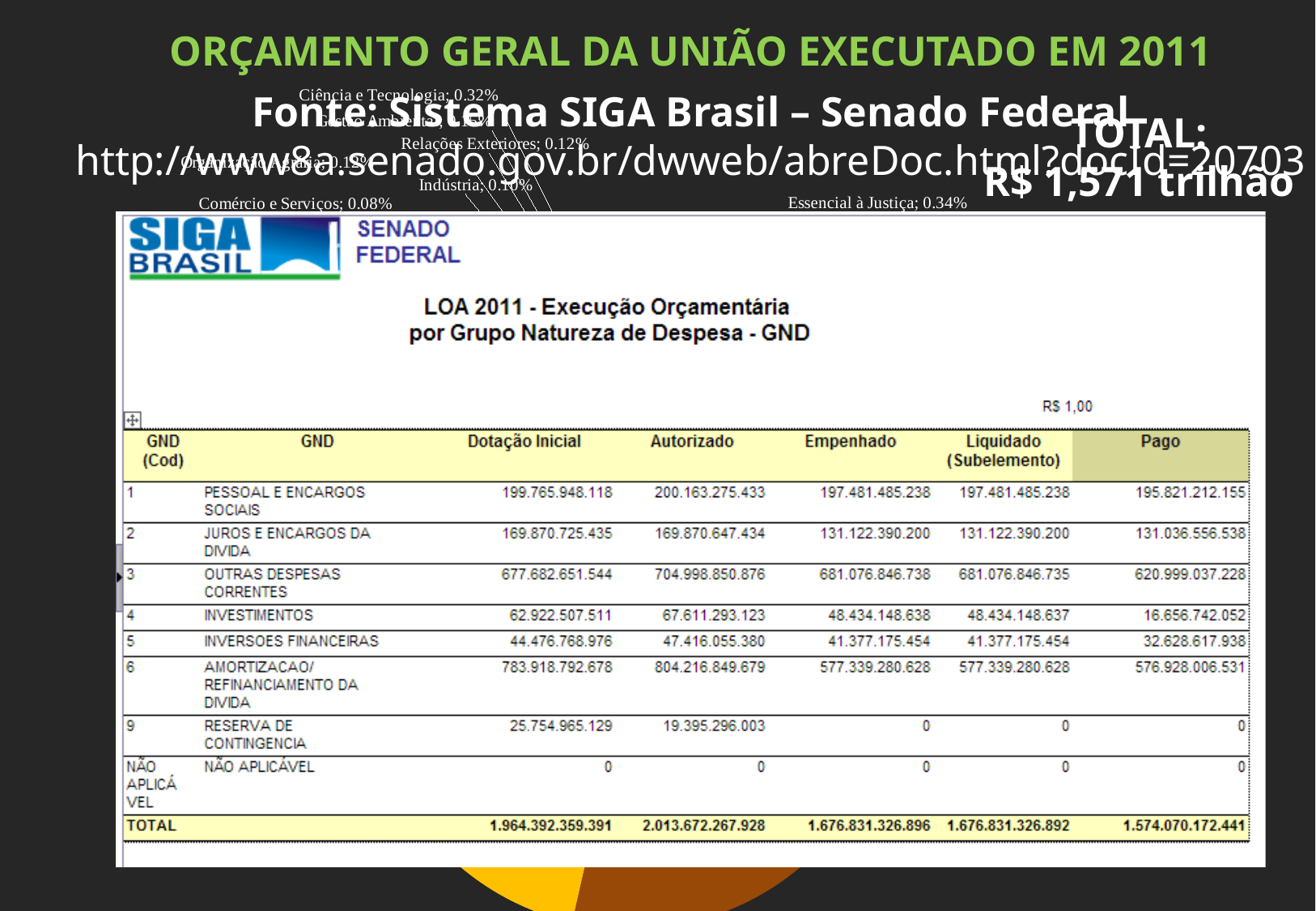
Among the labelled slices Comércio e Serviços, Indústria and Relações Exteriores, which has the smallest share? Comércio e Serviços What kind of chart is partially visible behind the table on the slide? pie chart What share does the Relações Exteriores slice have in the pie chart? 0.12% What is the title shown at the top of the slide above the chart? ORÇAMENTO GERAL DA UNIÃO EXECUTADO EM 2011 What share does the Ciência e Tecnologia slice have in the pie chart? 0.32% What share does the Indústria slice have in the pie chart? 0.10% In the pie chart, what is the difference between the shares of Relações Exteriores and Indústria? 0.02% What share does the Comércio e Serviços slice have in the pie chart? 0.08% In the pie chart, which is larger: Essencial à Justiça or Ciência e Tecnologia? Essencial à Justiça What share does the Essencial à Justiça slice have in the pie chart? 0.34% In the pie chart, what is the difference between the shares of Ciência e Tecnologia and Comércio e Serviços? 0.24% What total amount is stated on the slide next to the chart? R$ 1,571 trilhão